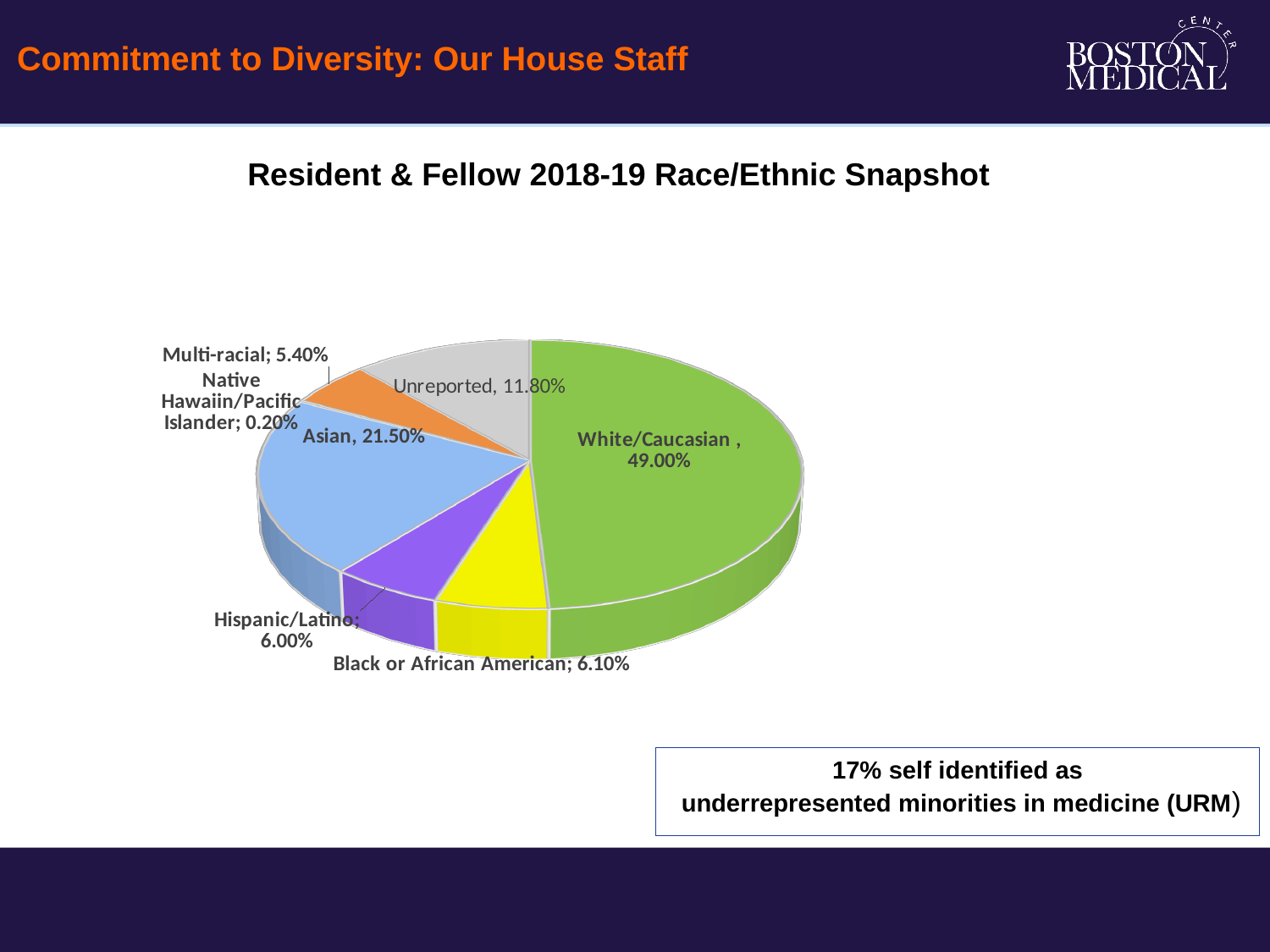
What percentage of residents and fellows are White/Caucasian? 49.00% What percentage is shown for Asian? 21.50% Which category has the smallest share of the pie? Native Hawaiin/Pacific Islander What is the title of the chart? Resident & Fellow 2018-19 Race/Ethnic Snapshot What is the difference between the White/Caucasian share and the Asian share? 27.50% What percentage is shown for Multi-racial? 5.40% What percentage is Unreported? 11.80% Which is larger, the Unreported share or the Multi-racial share? Unreported What percentage is shown for Native Hawaiin/Pacific Islander? 0.20% How many categories are shown in the pie chart? 7 Which category has the largest share of the pie? White/Caucasian What type of chart is shown on the slide? Pie chart